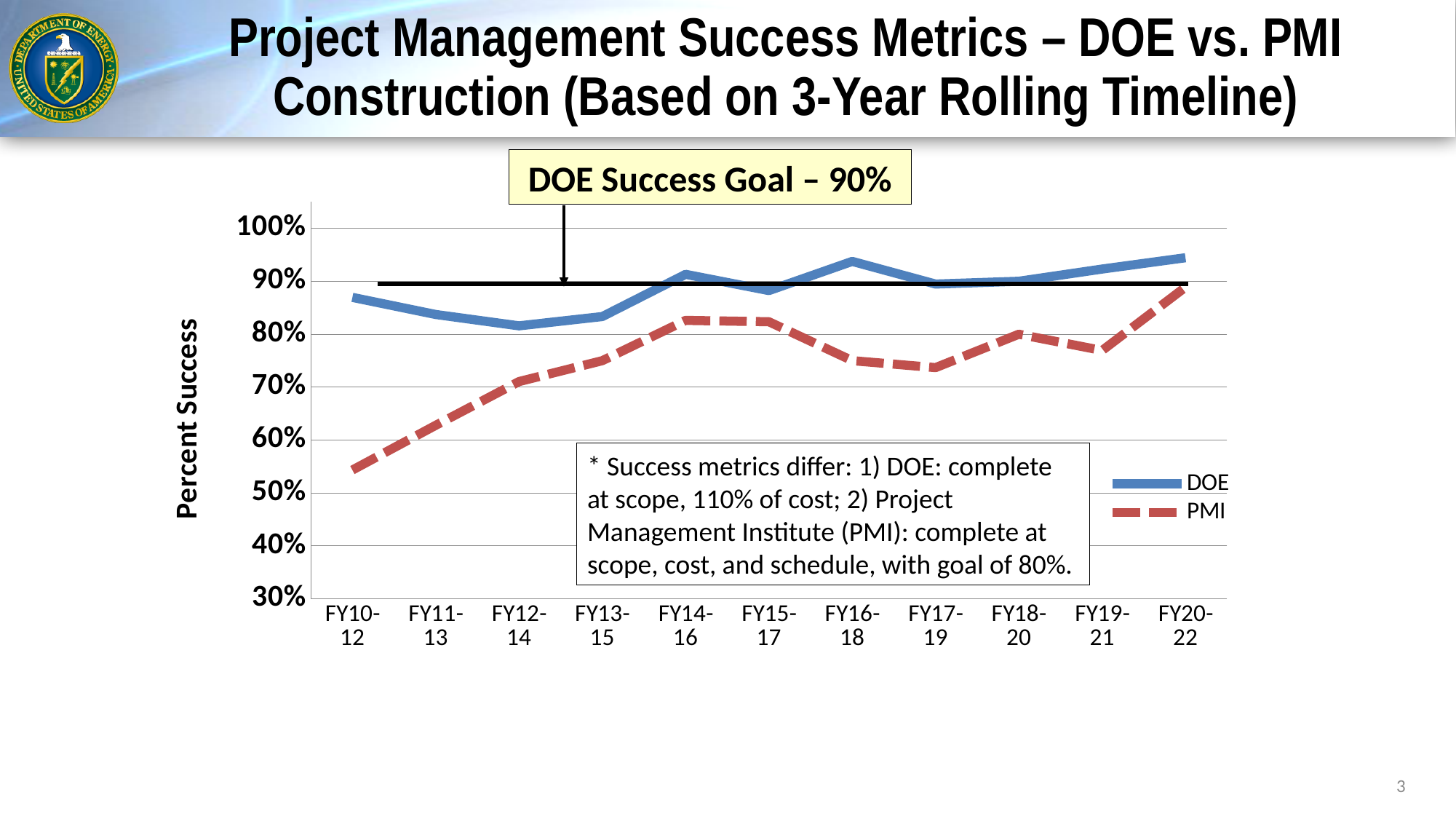
Is the DOE value for FY12-14 greater or less than 90%? less How many series does the legend list? 2 How many fiscal-year periods are plotted along the x axis? 11 Does the PMI series rise or fall from FY10-12 to FY14-16? rise Is the PMI value for FY10-12 greater or less than 60%? less Is the PMI value for FY17-19 greater or less than 80%? less In which period is the PMI series at its highest? FY20-22 What DOE success goal is marked by the horizontal line on the chart? 90% In which period is the PMI series at its lowest? FY10-12 Which series has the higher value at FY10-12, DOE or PMI? DOE What kind of chart is shown on the slide? line chart